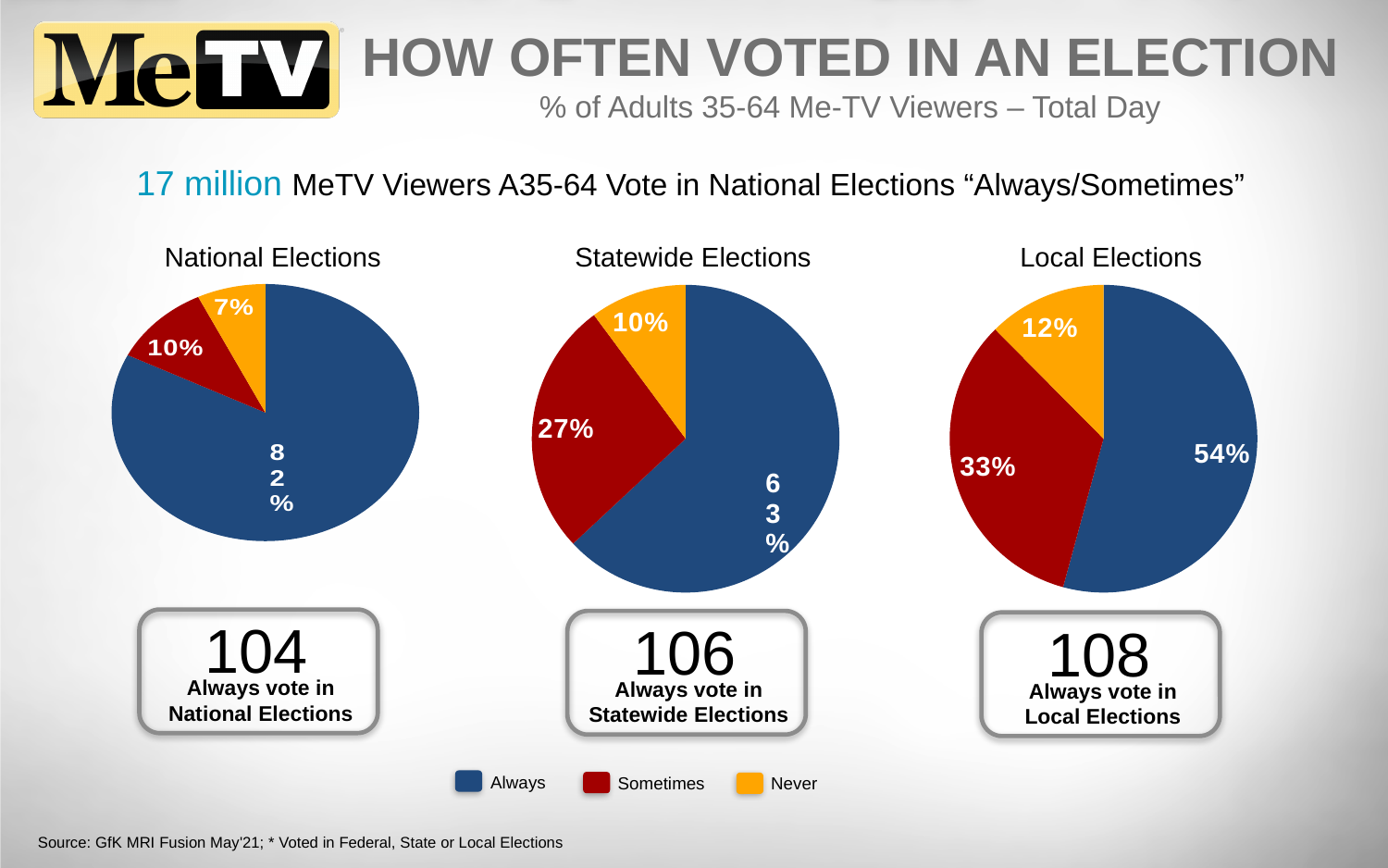
In the Statewide Elections pie chart, what percentage of viewers answered "Sometimes"? 27% In the Local Elections pie chart, what percentage of viewers answered "Never"? 12% How many categories does the legend list? 3 In the Local Elections pie chart, which response has the largest share? Always What type of chart is used to show the National Elections data? Pie chart Which colour represents "Sometimes" in the legend? Red In the National Elections pie chart, which response has the smallest share? Never How many pie charts are shown on the slide? 3 In the Statewide Elections pie chart, what share of the pie is "Never"? 10% In the National Elections pie chart, what percentage of viewers answered "Always"? 82% In the Statewide Elections pie chart, what is the difference between the "Always" and "Sometimes" shares? 36% Which is larger: the "Sometimes" share in the Local Elections pie chart or the "Sometimes" share in the National Elections pie chart? Local Elections